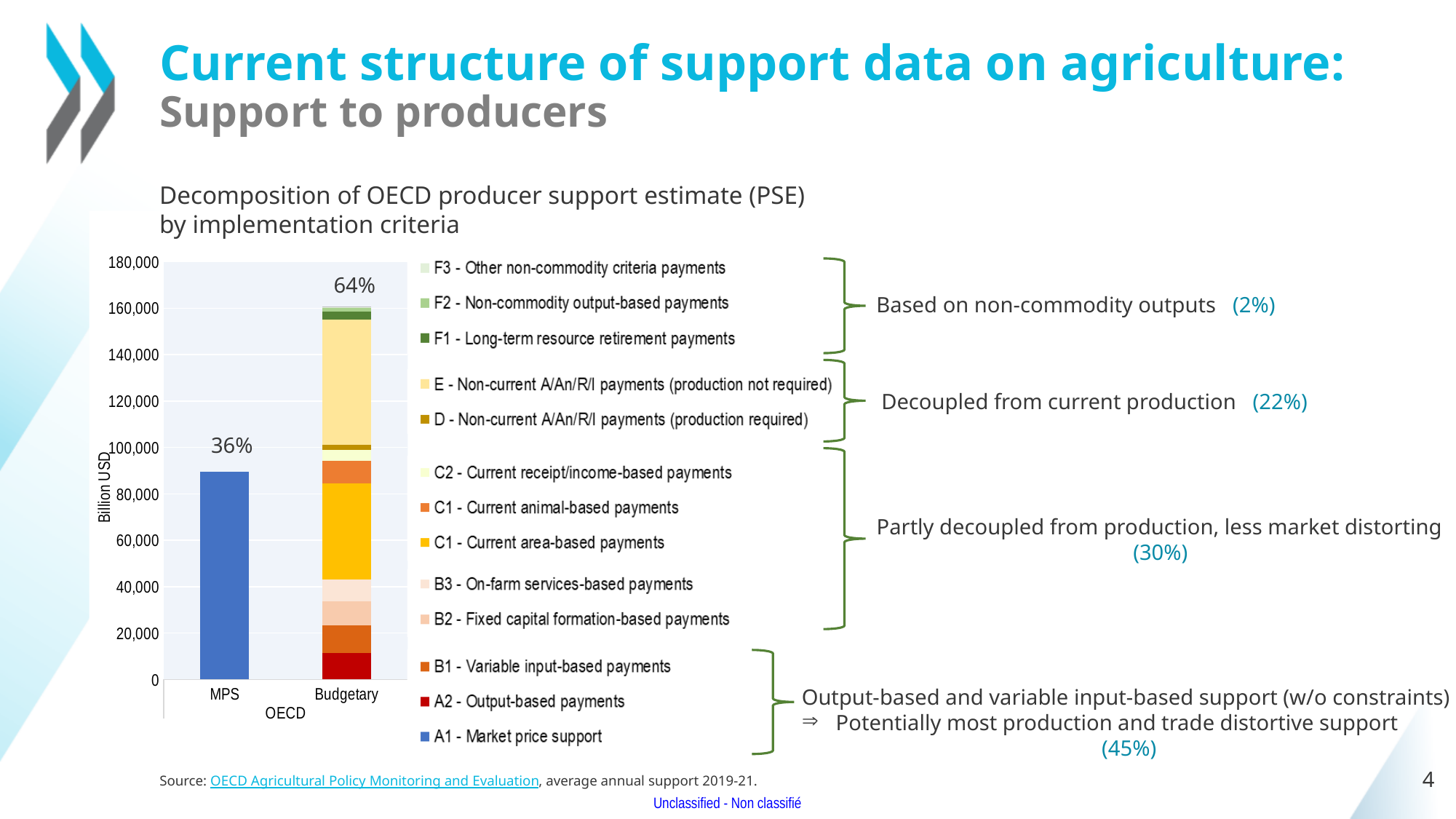
What percentage label is shown above the MPS bar? 36% How many bars (categories) are plotted on the x axis of the chart? 2 Which legend entry corresponds to the blue series that makes up the MPS bar? A1 - Market price support Is the total value of the Budgetary bar greater or less than 140,000? greater Is the value for MPS greater or less than 100,000? less What percentage label is shown above the Budgetary bar? 64% Which category has the highest total value in the chart? Budgetary What kind of chart is shown on the slide? bar chart What is the label on the y axis of the chart? Billion USD Which bar is taller, MPS or Budgetary? Budgetary What is the difference in percentage points between the Budgetary label (64%) and the MPS label (36%)? 28 How many series does the chart's legend list? 13